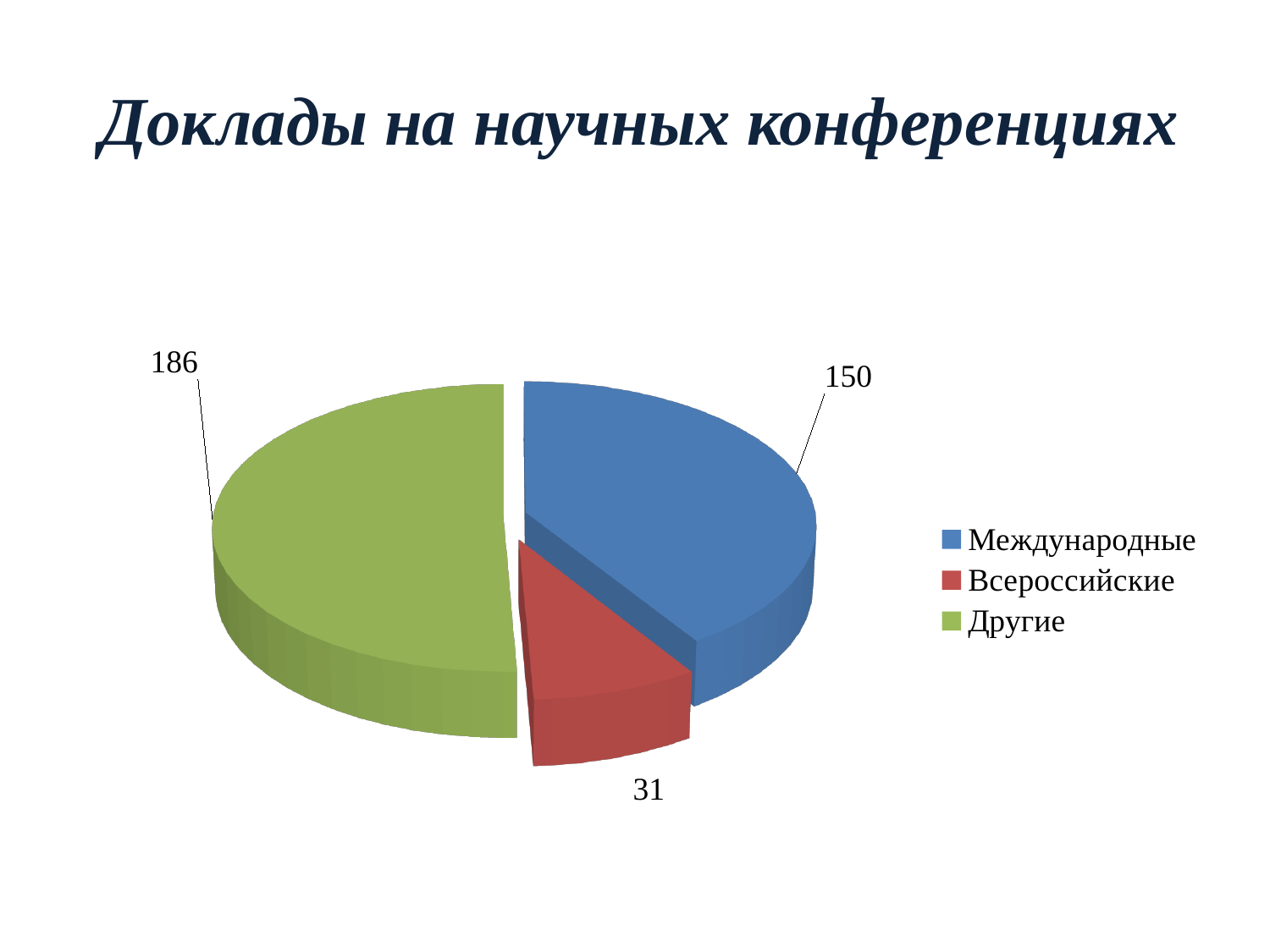
What is the value for Международные? 150 What is the difference between the values for Международные and Всероссийские? 119 Which category has the largest slice of the pie? Другие What is the difference between the values for Другие and Международные? 36 What is the total of all three slices in the pie chart? 367 Which is larger, the value for Международные or the value for Всероссийские? Международные What is the value for Всероссийские? 31 What is the title of the slide containing the chart? Доклады на научных конференциях How many categories does the pie chart have? 3 What type of chart is shown on the slide? pie chart What is the value for Другие? 186 Which category has the smallest slice of the pie? Всероссийские